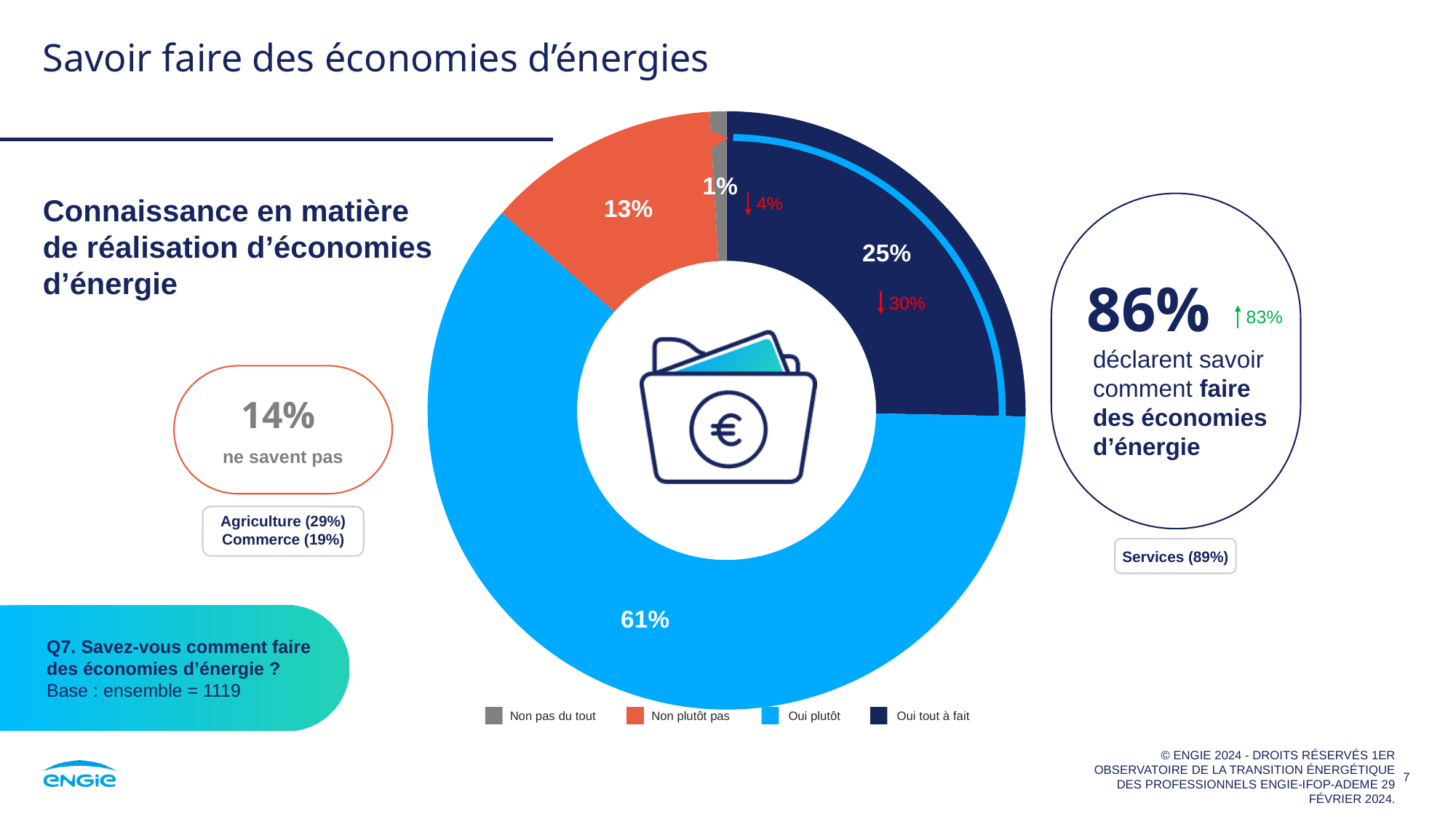
Which is larger: the share for "Non plutôt pas" or the share for "Oui tout à fait"? Oui tout à fait What percentage of respondents answered "Oui tout à fait"? 25% What colour is the "Non plutôt pas" segment in the pie chart? Orange What kind of chart is shown on the slide? Doughnut chart Which response category has the smallest share of the pie? Non pas du tout How many response categories are shown in the pie chart? 4 What percentage of respondents answered "Non pas du tout"? 1% What percentage of respondents answered "Oui plutôt"? 61% How many entries does the legend list? 4 What is the difference in percentage points between "Oui plutôt" and "Oui tout à fait"? 36 What percentage of respondents answered "Non plutôt pas"? 13% Which response category has the largest share of the pie? Oui plutôt